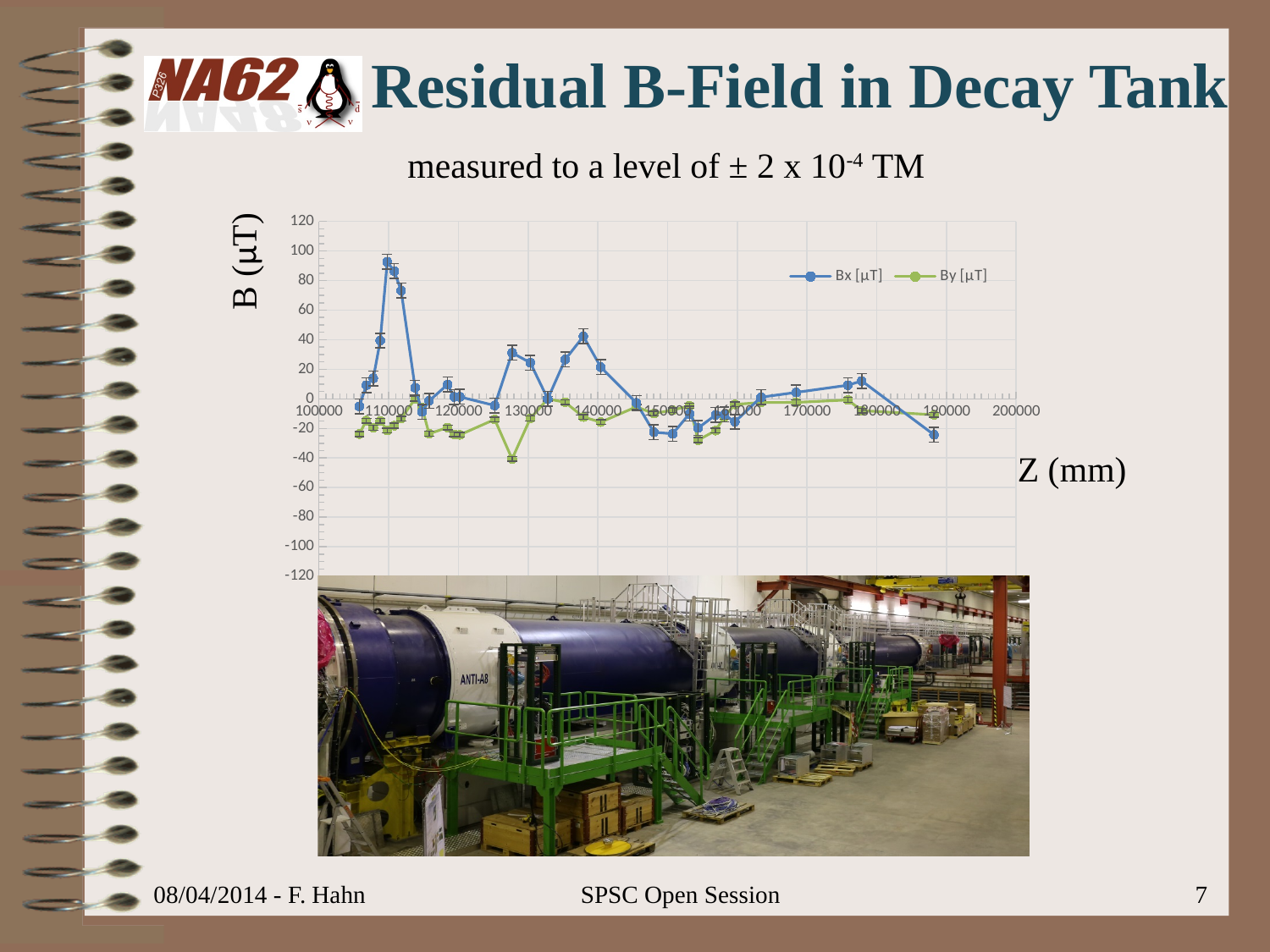
Is the maximum value of Bx [µT] greater or less than 80? greater What kind of chart is shown on the slide? line chart What is the label of the vertical axis of the chart? B (µT) Near which labelled Z value does Bx [µT] reach its maximum? 110000 What are the two series named in the chart legend? Bx [µT] and By [µT] Is the lowest value of By [µT] greater or less than -20? less Which series reaches the lowest (most negative) value, Bx [µT] or By [µT]? By [µT] How many series does the chart legend list? 2 Does Bx [µT] rise or fall between its peak near Z = 110000 and Z = 120000? fall Is the last Bx [µT] point (near Z = 190000) greater or less than 0? less Which series reaches the higher maximum value, Bx [µT] or By [µT]? Bx [µT]